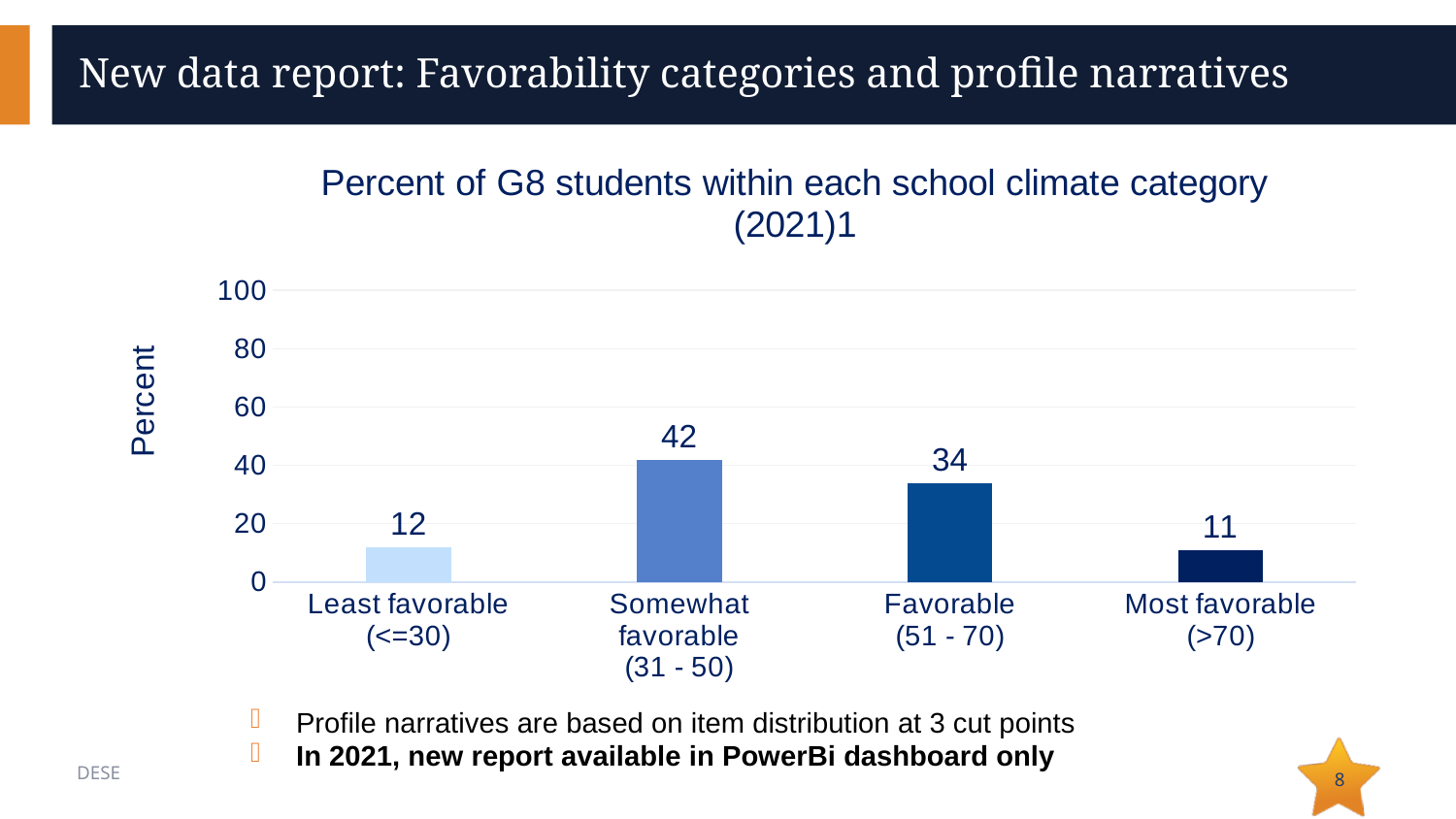
Which school climate category has the highest percent of G8 students? Somewhat favorable (31 - 50) What kind of chart is shown on the slide? Bar chart What percent of G8 students are in the Most favorable (>70) category? 11 What percent of G8 students are in the Favorable (51 - 70) category? 34 How many school climate categories are shown in the chart? 4 Which school climate category has the lowest percent of G8 students? Most favorable (>70) Is the value for Somewhat favorable greater or less than 40? greater What is the difference in percent between the Somewhat favorable and Favorable categories? 8 What percent of G8 students are in the Somewhat favorable (31 - 50) category? 42 What is the label on the vertical axis of the chart? Percent What percent of G8 students are in the Least favorable (<=30) category? 12 Which category has a larger percent of students: Least favorable or Favorable? Favorable